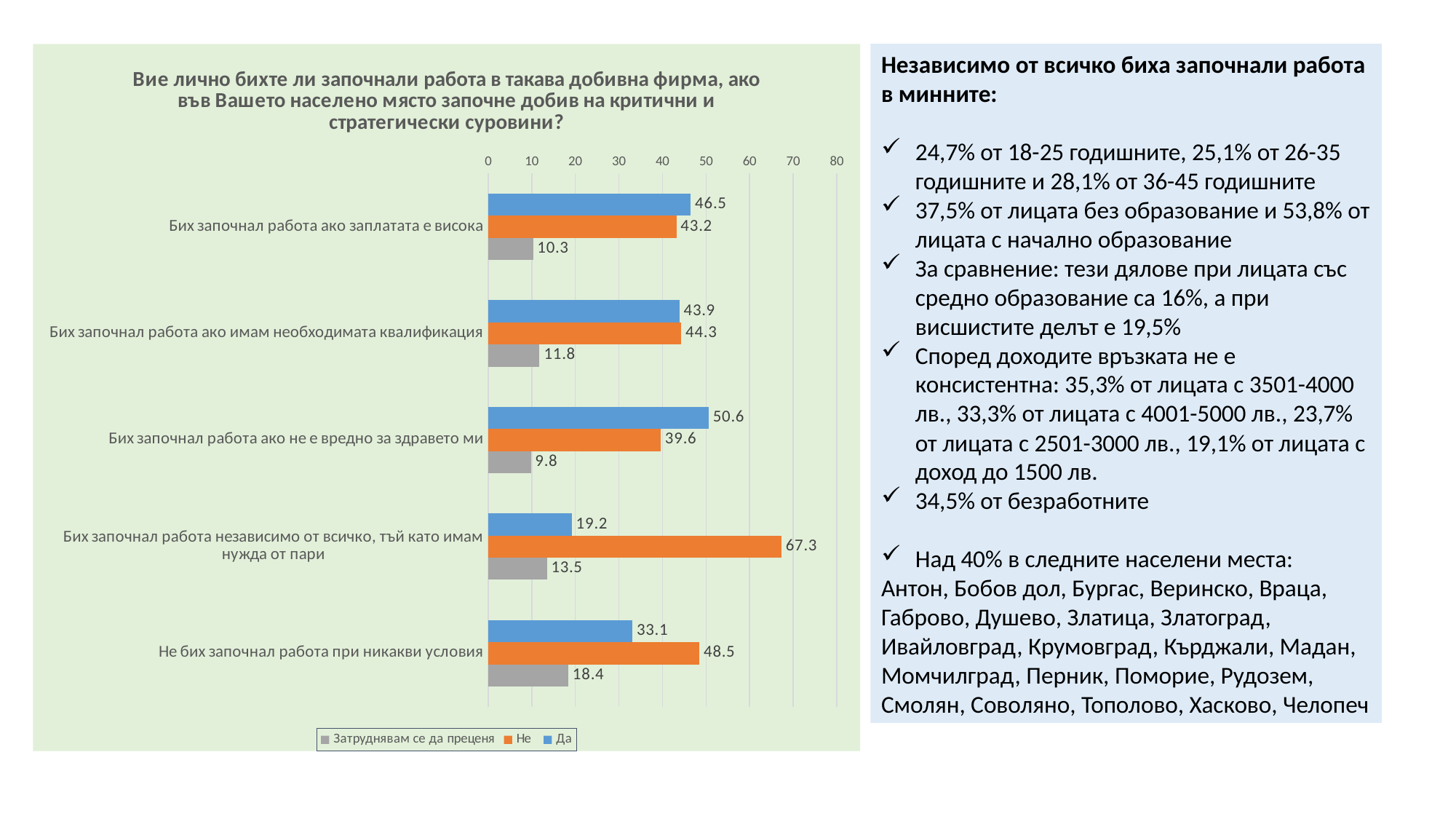
For "Не бих започнал работа при никакви условия", which is larger: the "Да" value or the "Не" value? Не Is the "Да" value for "Бих започнал работа ако заплатата е висока" greater or less than 40? greater What is the value of the "Затруднявам се да преценя" series for "Не бих започнал работа при никакви условия"? 18.4 Which category has the highest value in the "Да" series? Бих започнал работа ако не е вредно за здравето ми What is the value of the "Да" series for "Бих започнал работа ако не е вредно за здравето ми"? 50.6 Which category has the lowest value in the "Затруднявам се да преценя" series? Бих започнал работа ако не е вредно за здравето ми Which colour represents the "Не" series in the chart? orange What type of chart is shown on the slide? bar chart What is the value of the "Не" series for "Бих започнал работа независимо от всичко, тъй като имам нужда от пари"? 67.3 What is the difference between the "Не" and "Да" values for "Бих започнал работа независимо от всичко, тъй като имам нужда от пари"? 48.1 How many categories are shown on the chart? 5 How many series does the legend list? 3